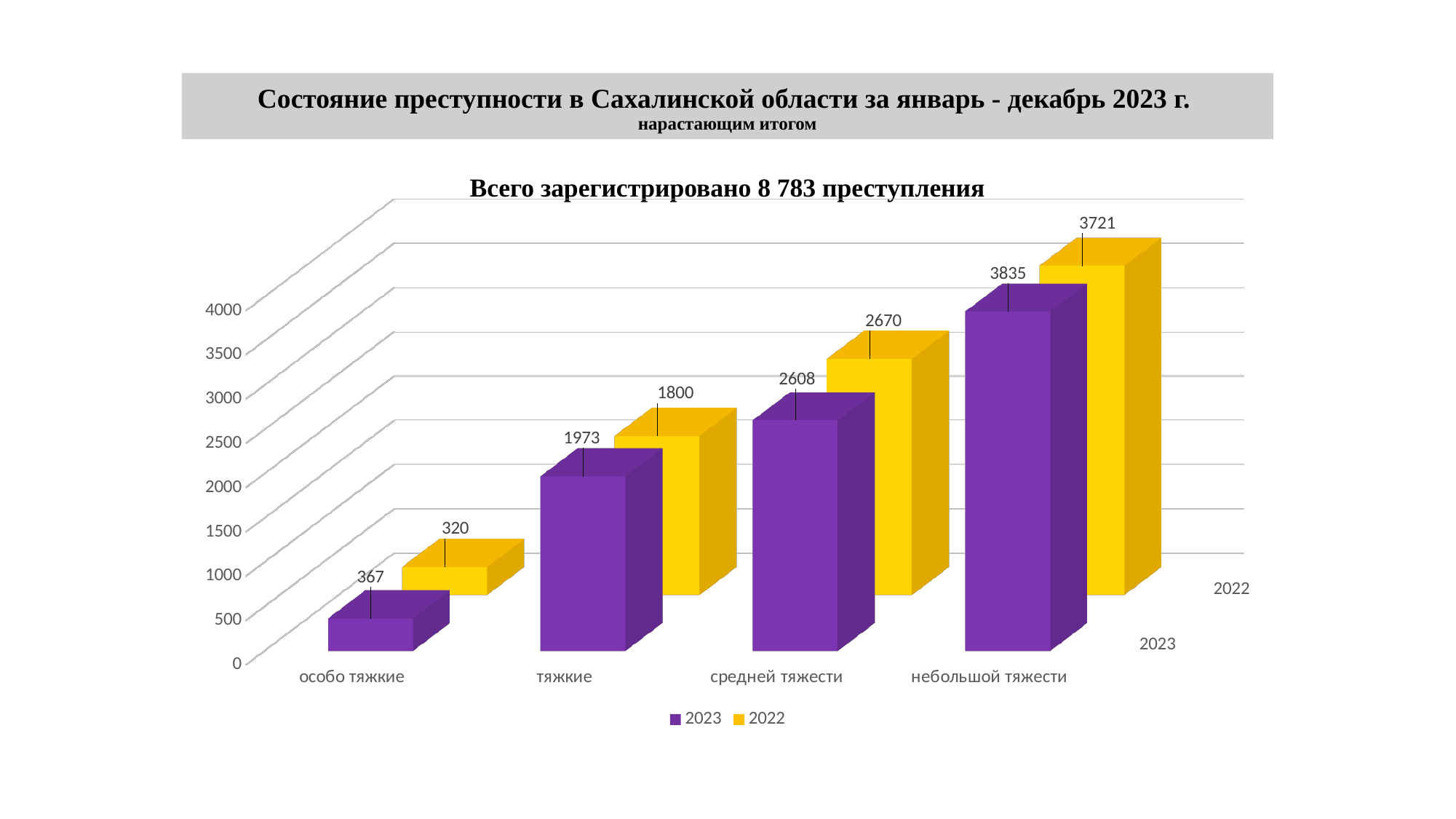
Which category has the lowest value in the 2023 series? особо тяжкие What is the difference between the 2023 and 2022 values for 'тяжкие'? 173 What is the value for 'тяжкие' in the 2022 series? 1800 What is the difference between the 2023 and 2022 values for 'небольшой тяжести'? 114 What is the value for 'особо тяжкие' in the 2023 series? 367 What kind of chart is shown on the slide? bar chart Which category has the highest value in the 2022 series? небольшой тяжести How many series does the legend list? 2 Which is larger for 'средней тяжести': the 2023 value or the 2022 value? 2022 How many categories are shown on the x axis? 4 What total number of registered crimes is stated in the chart title? 8 783 What is the value for 'небольшой тяжести' in the 2023 series? 3835